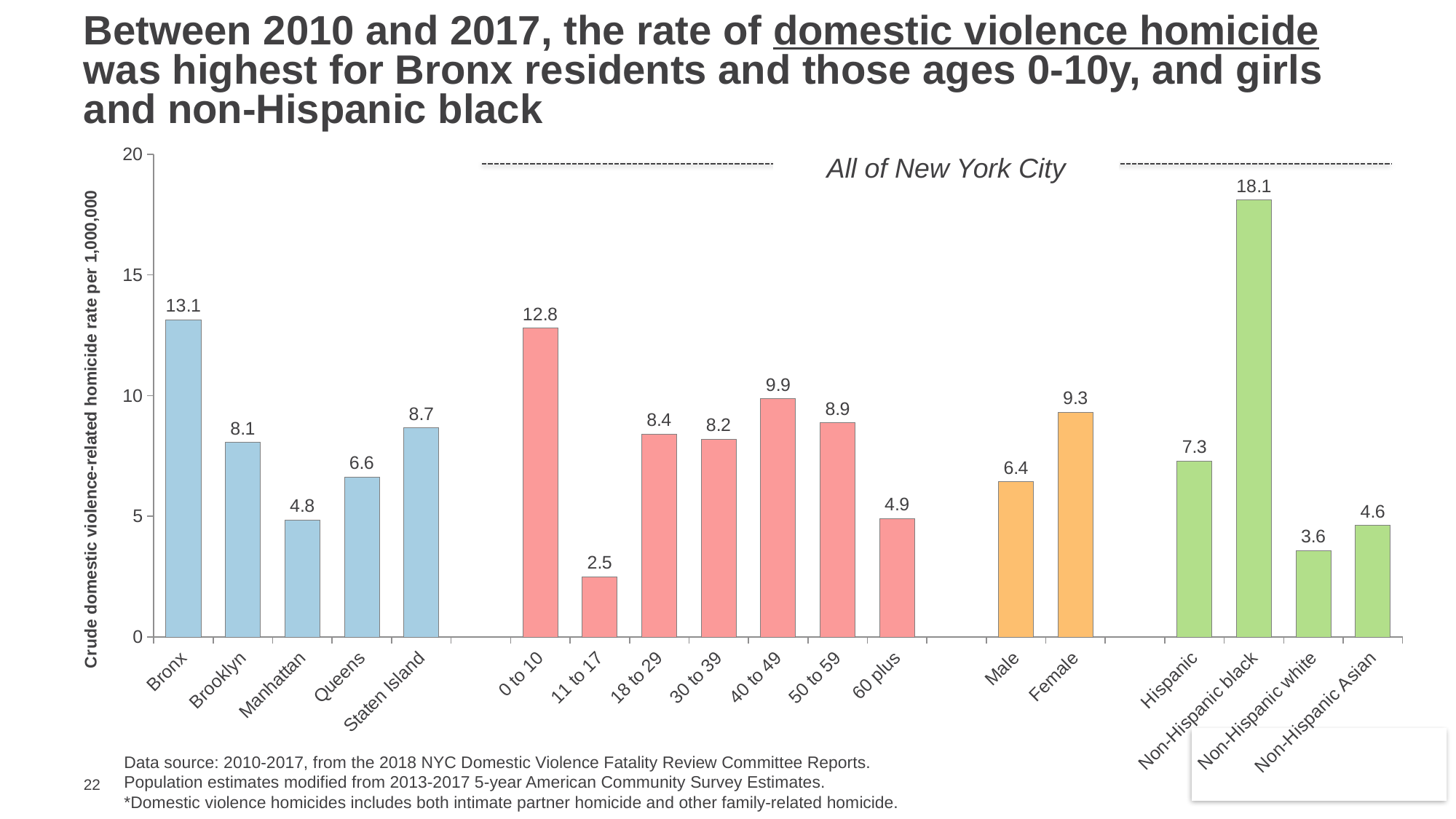
What is the rate shown for Non-Hispanic white residents? 3.6 What is the rate shown for the 11 to 17 age group? 2.5 What is the crude domestic violence-related homicide rate per 1,000,000 for Bronx residents? 13.1 What is the difference between the rates for Female and Male? 2.9 Which category has the lowest rate on the chart? 11 to 17 Which has a higher rate, the 40 to 49 age group or the 50 to 59 age group? 40 to 49 How many bars are plotted on the chart? 18 Which has a higher rate, Staten Island or Brooklyn? Staten Island What kind of chart is shown on the slide? Bar chart What is the difference between the rates for Bronx and Manhattan? 8.3 Which category has the highest rate on the chart? Non-Hispanic black Is the value for Hispanic greater or less than 10? less